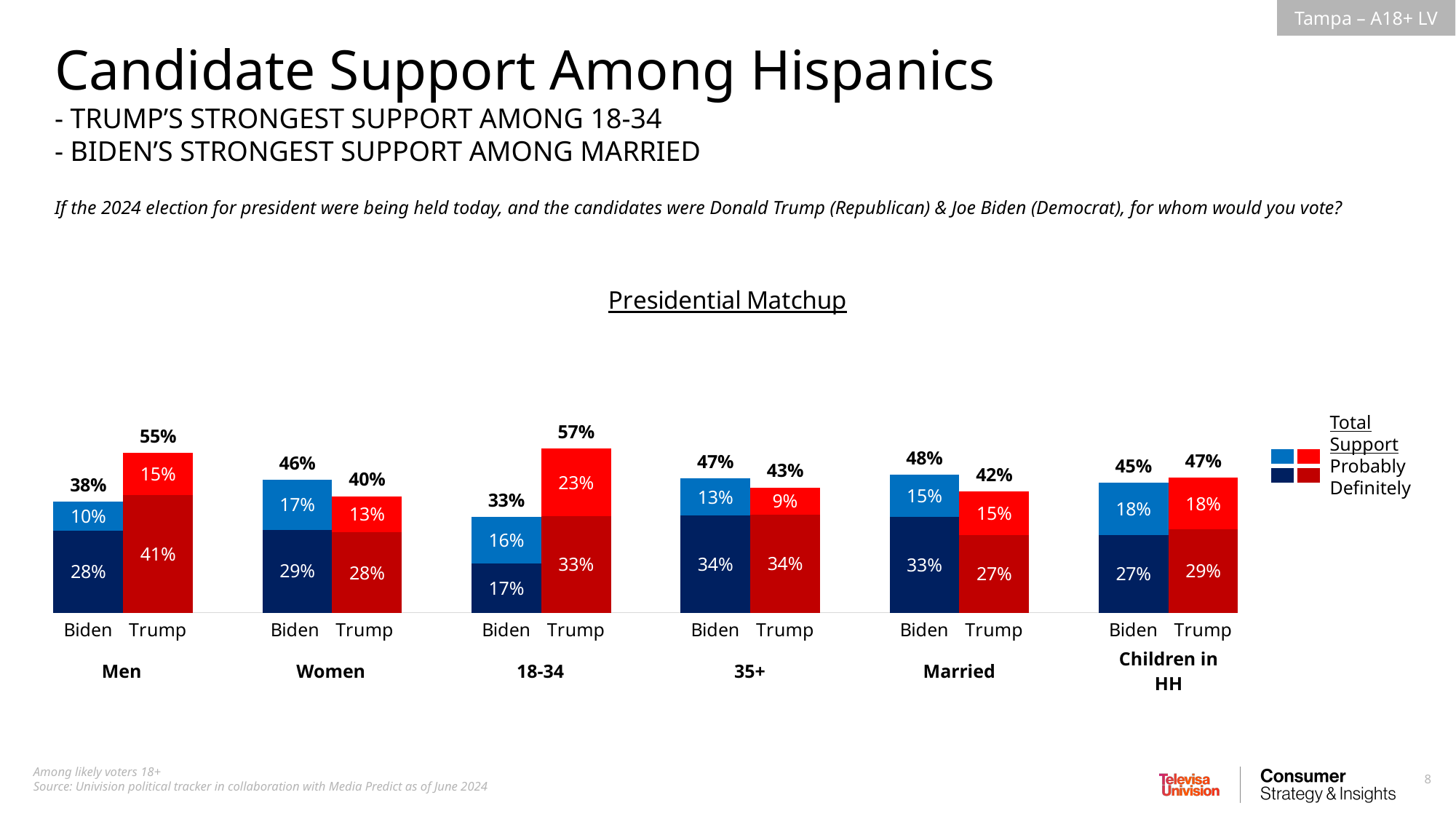
What is the 'Probably' support for Trump among 18-34? 23% In which group is Trump's total support highest? 18-34 What is the difference between Trump's and Biden's total support among 18-34? 24 percentage points Among 35+, who has higher total support, Biden or Trump? Biden What is the title of the chart? Presidential Matchup What kind of chart is shown on the slide? Stacked bar chart In which group is Biden's total support lowest? 18-34 What is the 'Definitely' support for Biden among Women? 29% How many demographic groups are shown on the chart? 6 What is the total support for Biden among Married? 48% What is the sum of 'Definitely' and 'Probably' support for Biden among Children in HH? 45% What is the total support for Trump among Men? 55%